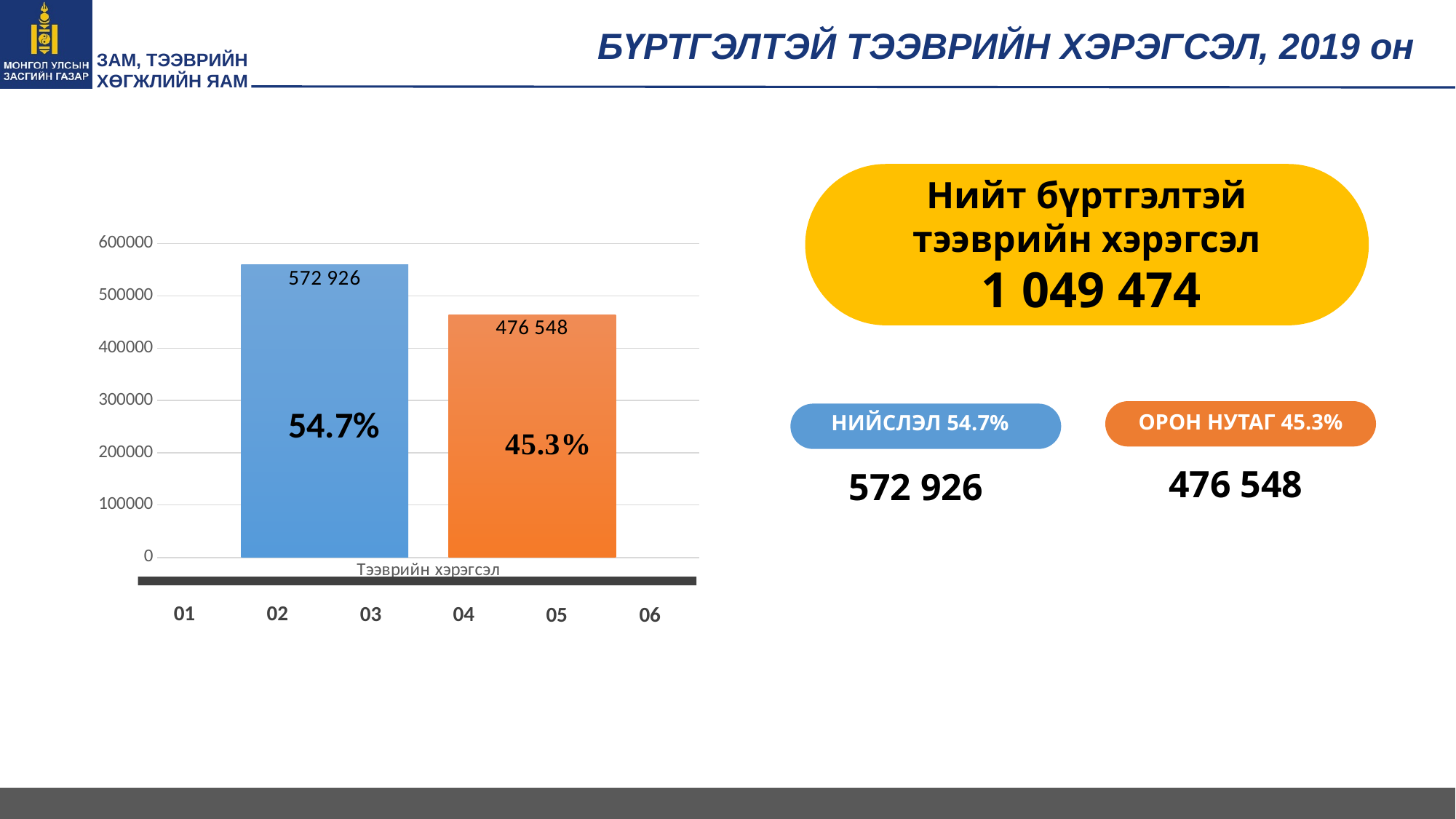
What percentage is shown inside the blue bar? 54.7% What is the highest tick value shown on the vertical axis of the chart? 600000 What value is printed on the orange bar in the chart? 476 548 What is the category label shown under the bars on the x axis? Тээврийн хэрэгсэл How many bars are plotted in the chart? 2 What is the difference between the values of the blue bar (572 926) and the orange bar (476 548)? 96 378 What type of chart is shown on the slide? bar chart Is the value of the blue bar greater or less than 500000? greater What value is printed on the blue bar in the chart? 572 926 Is the value of the orange bar greater or less than 500000? less What percentage is shown inside the orange bar? 45.3% Which bar is taller, the blue bar or the orange bar? the blue bar